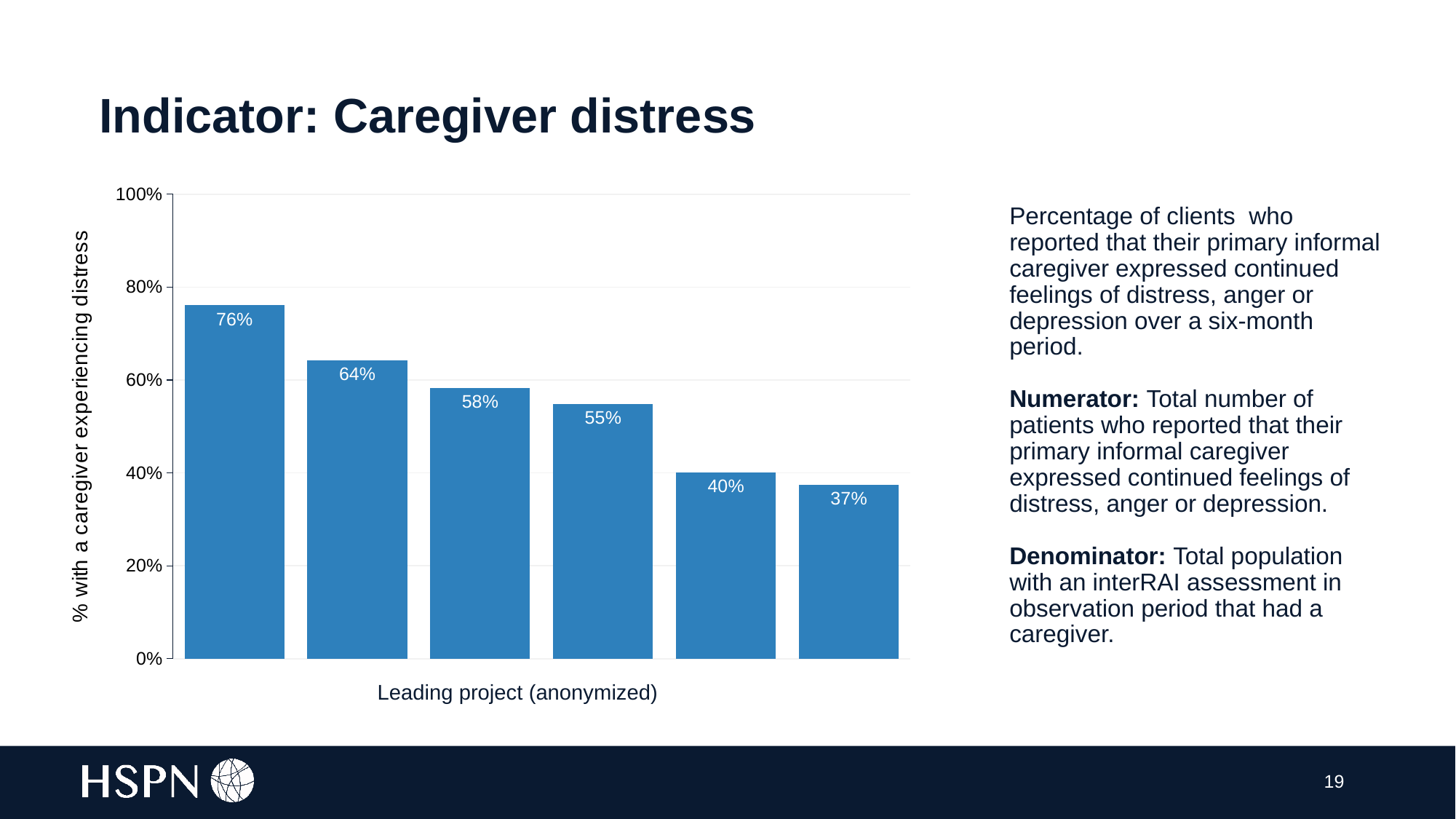
What is the value shown on the last (rightmost) bar? 37% What is the lowest value shown on any bar in the chart? 37% What is the highest value shown on any bar in the chart? 76% Is the value of the second bar from the left greater or less than 60%? greater What is the value shown on the fourth bar from the left? 55% How many bars are plotted in the chart? 6 What is the difference between the first bar (76%) and the second bar (64%)? 12% What is the value shown on the first (leftmost) bar? 76% Do the bar values rise or fall from left to right across the chart? Fall What kind of chart is shown on the slide? Bar chart What is the difference between the highest bar and the lowest bar? 39% Which is larger, the third bar from the left or the fifth bar from the left? The third bar (58%)